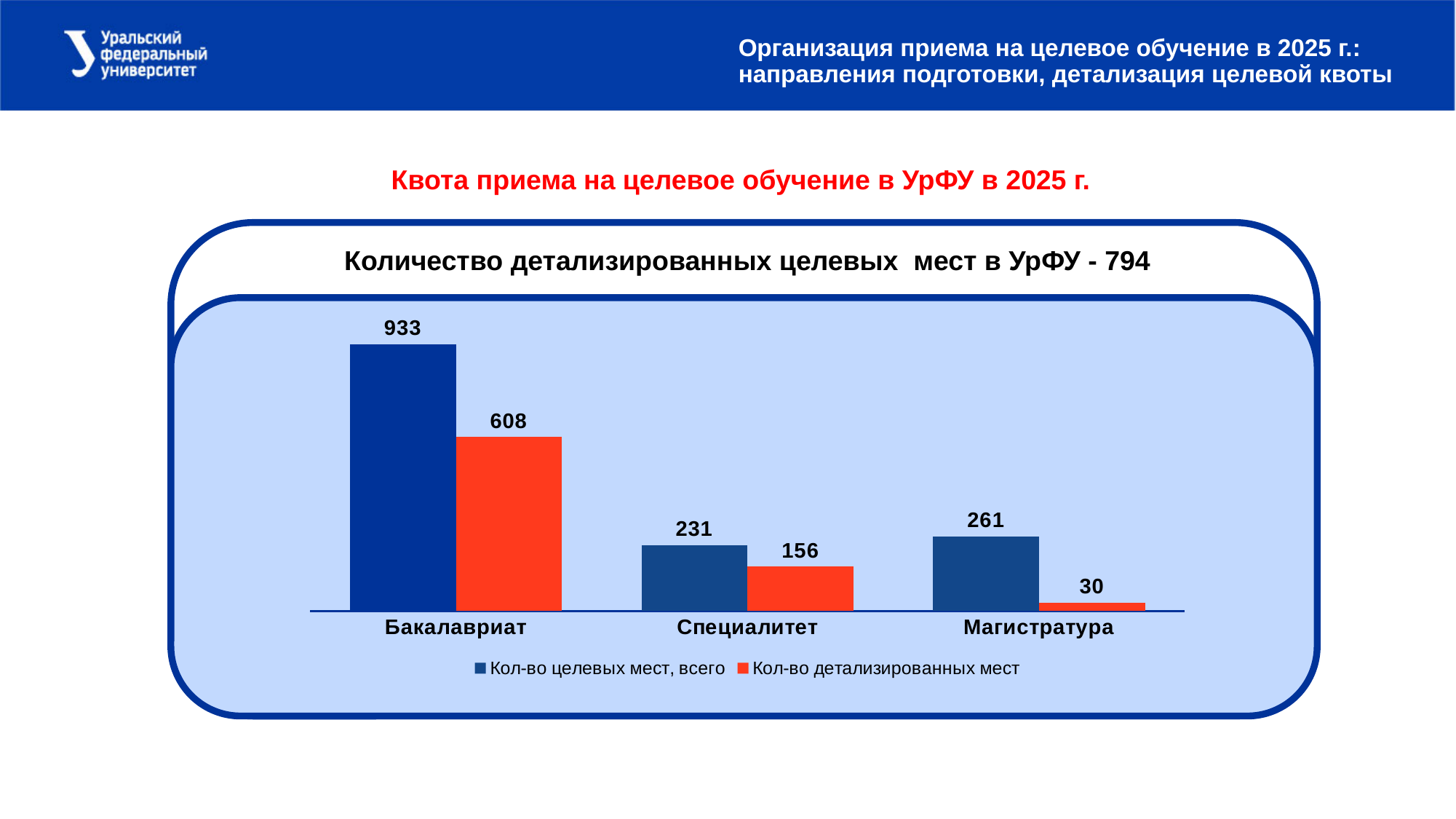
How many series does the legend list? 2 What is the value of 'Кол-во детализированных мест' for Специалитет? 156 What is the difference between 'Кол-во целевых мест, всего' and 'Кол-во детализированных мест' for Бакалавриат? 325 What is the value of 'Кол-во целевых мест, всего' for Магистратура? 261 What kind of chart is shown on the slide? Bar chart Which category has the highest value for 'Кол-во целевых мест, всего'? Бакалавриат Which is larger: 'Кол-во целевых мест, всего' for Специалитет or for Магистратура? Магистратура What colour are the bars for 'Кол-во детализированных мест'? Red What is the value of 'Кол-во целевых мест, всего' for Бакалавриат? 933 Which category has the lowest value for 'Кол-во детализированных мест'? Магистратура What is the value of 'Кол-во детализированных мест' for Магистратура? 30 How many categories are shown on the x axis? 3